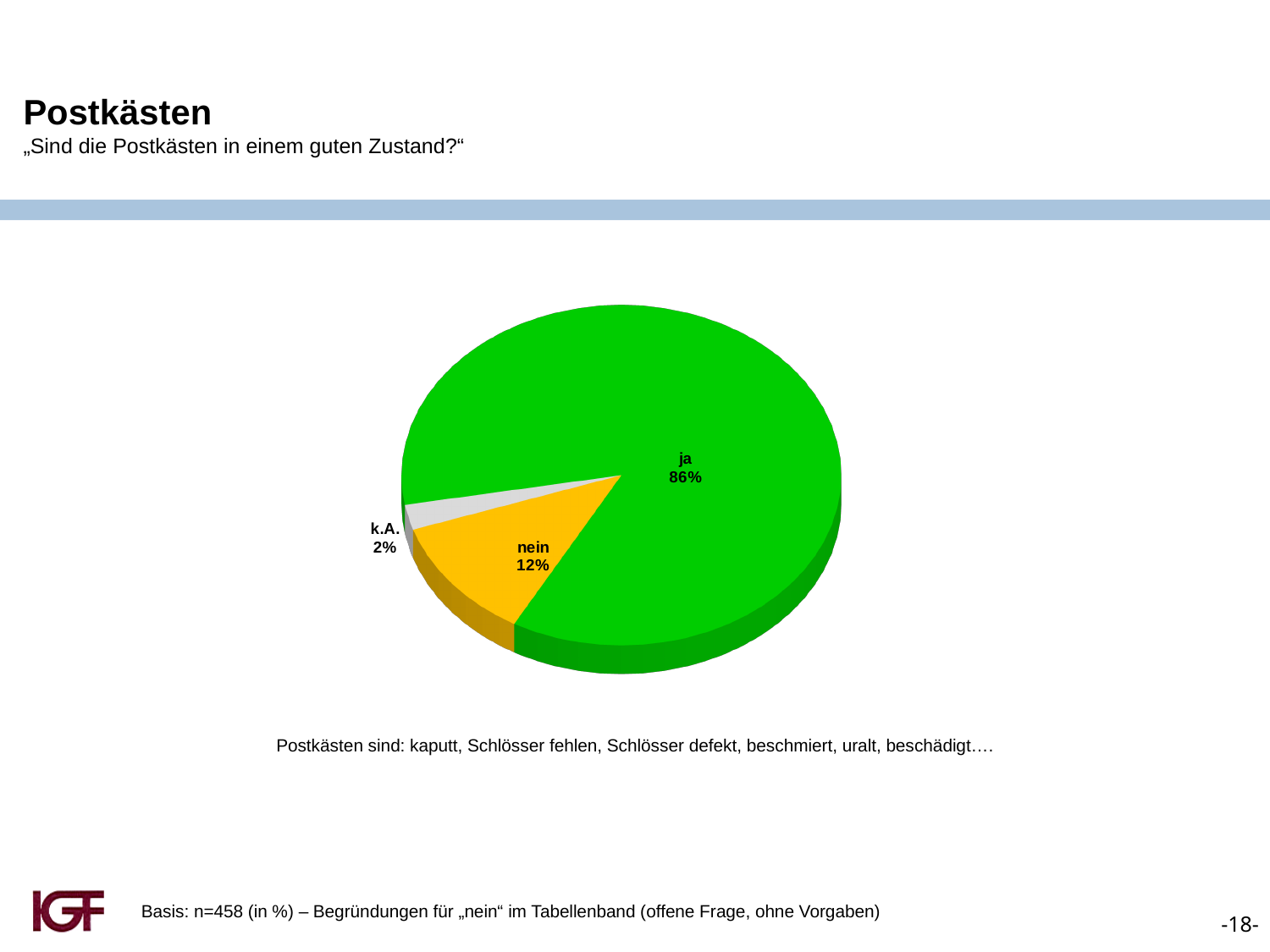
What is the sample size (n) stated at the bottom of the slide? n=458 Which slice of the pie is the smallest? k.A. What percentage of respondents answered "nein"? 12% What kind of chart is shown on the slide? pie chart What is the combined share of "nein" and "k.A."? 14% What colour is the "ja" slice? green What percentage is shown for "k.A."? 2% How many slices does the pie chart have? 3 What percentage of respondents answered "ja"? 86% What is the difference in percentage points between "ja" and "nein"? 74 Which slice of the pie is the largest? ja Which is larger, the share for "nein" or the share for "k.A."? nein